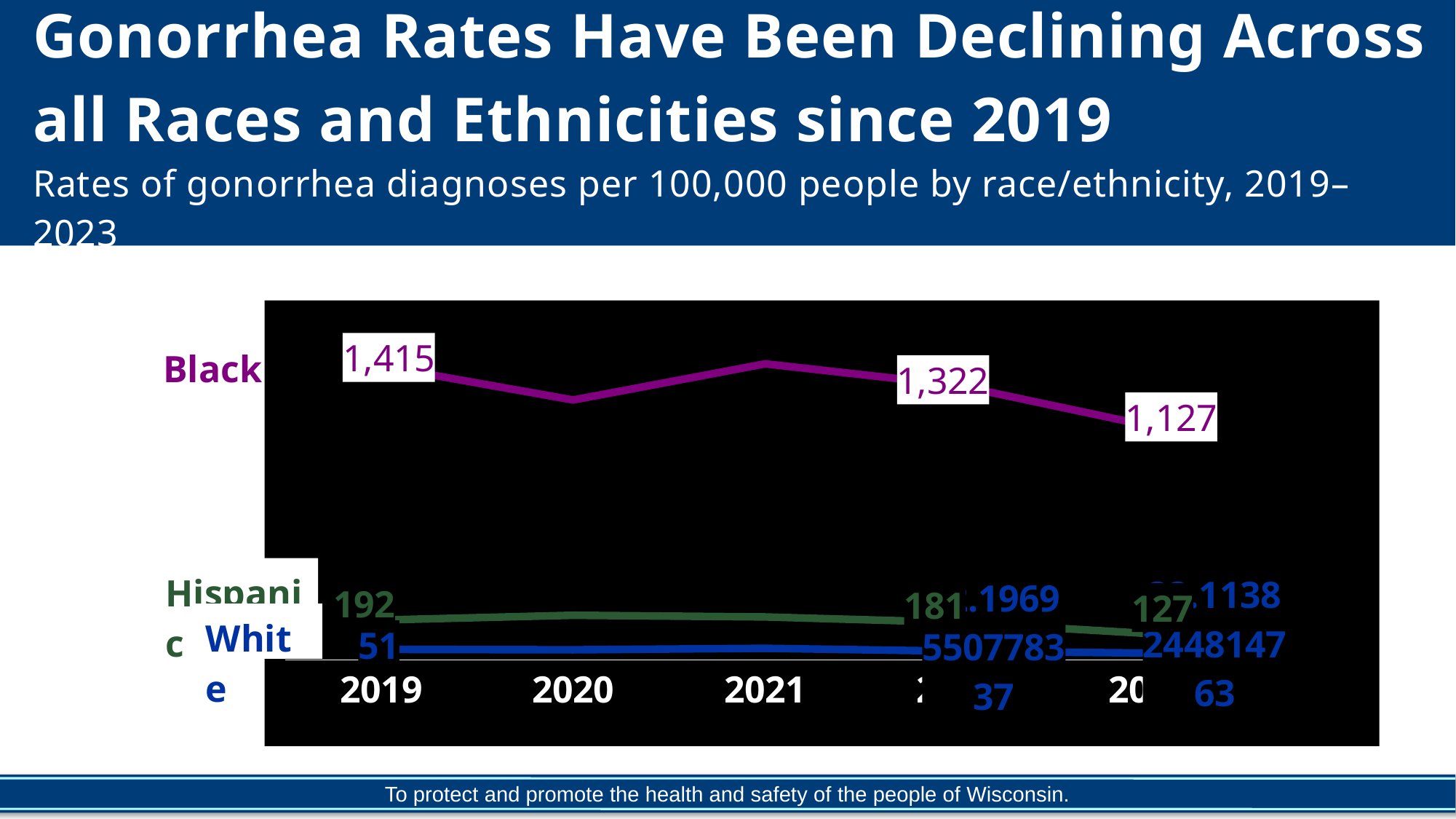
By how much did the Black series rate fall from 2019 to 2023? 288 What was the gonorrhea rate for the Hispanic series in 2019? 192 Which race/ethnicity had the lowest gonorrhea rate in 2019? White What kind of chart is shown on the slide? line chart In 2019, which was higher: the Black rate or the Hispanic rate? Black What was the gonorrhea rate for the White series in 2019? 51 What was the gonorrhea rate for the Black series in 2022? 1,322 What was the gonorrhea rate for the Black series in 2019? 1,415 Which race/ethnicity had the highest gonorrhea rate in 2019? Black What is the difference between the Black series rate in 2022 and in 2023? 195 What was the gonorrhea rate for the Black series in 2023? 1,127 Did the Black series rate rise or fall from 2022 to 2023? fall